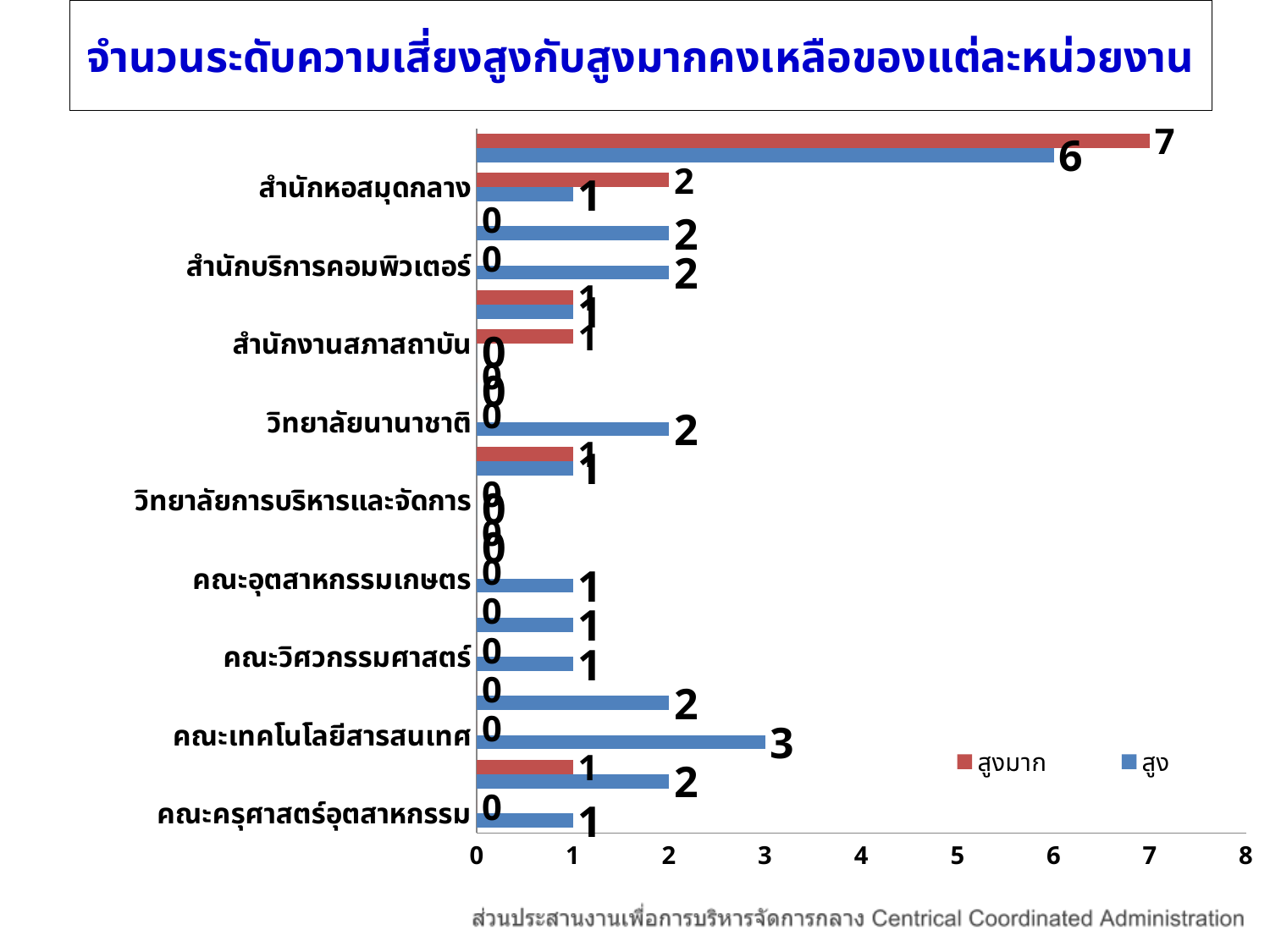
What is the สูง value for วิทยาลัยนานาชาติ? 2 What is the difference between the สูง value for คณะเทคโนโลยีสารสนเทศ and the สูง value for คณะครุศาสตร์อุตสาหกรรม? 2 What is the สูงมาก value for คณะเทคโนโลยีสารสนเทศ? 0 Which has the larger สูง value, คณะเทคโนโลยีสารสนเทศ or คณะวิศวกรรมศาสตร์? คณะเทคโนโลยีสารสนเทศ What kind of chart is shown on the slide? Bar chart What is the สูงมาก value for สำนักหอสมุดกลาง? 2 What are the two series named in the legend? สูงมาก and สูง What is the largest สูงมาก value shown on the chart? 7 What is the สูง value for สำนักบริการคอมพิวเตอร์? 2 How many series does the legend list? 2 What is the สูงมาก value for สำนักงานสภาสถาบัน? 1 What is the สูง value for คณะเทคโนโลยีสารสนเทศ? 3